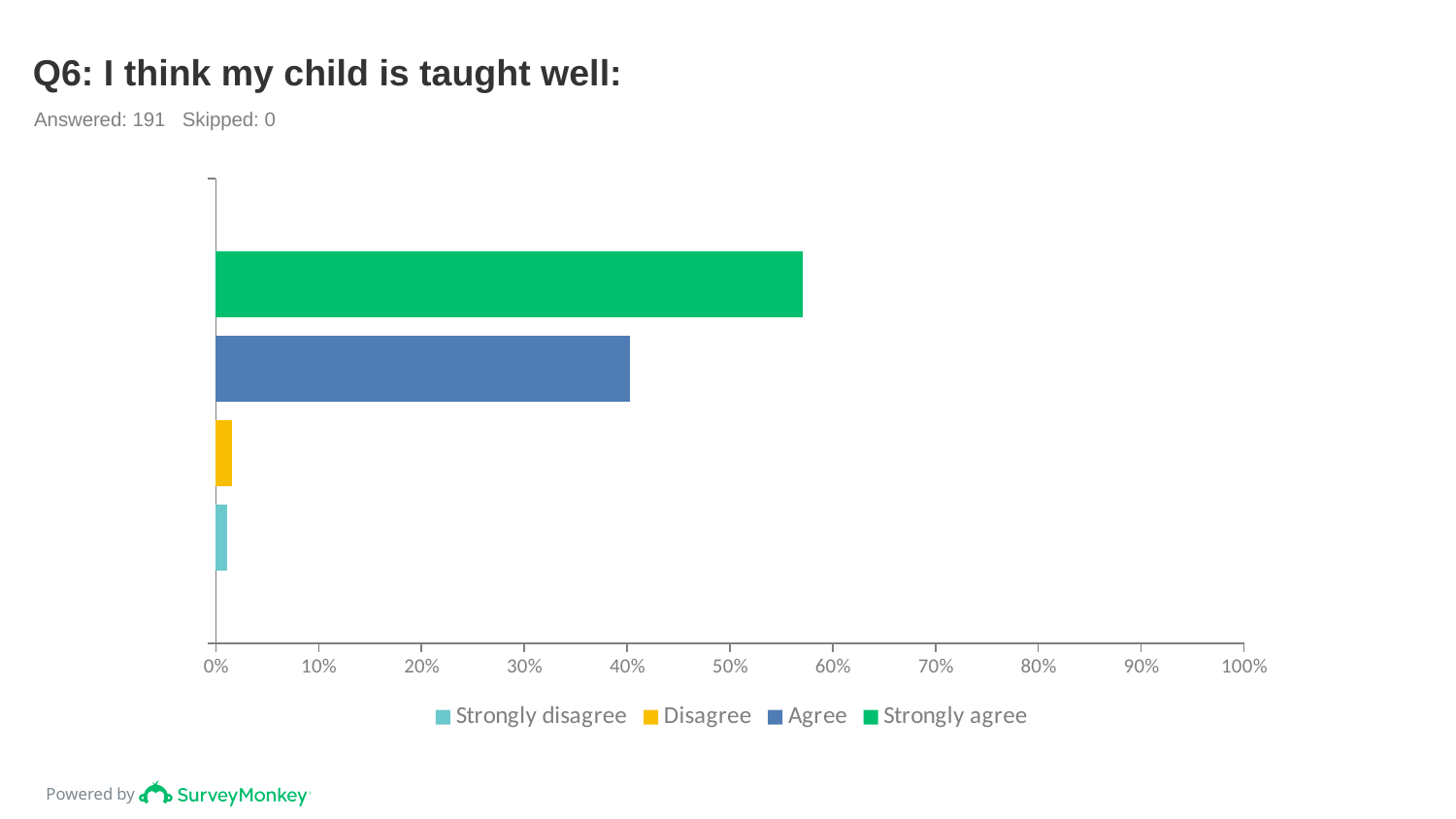
What is the title of the chart? Q6: I think my child is taught well: Which is larger, the value for Agree or the value for Strongly agree? Strongly agree Is the value for Strongly agree greater or less than 50%? greater Which response has the shortest bar? Strongly disagree Is the value for Disagree greater or less than 10%? less Is the value for Strongly agree greater or less than 60%? less Which response has the longest bar? Strongly agree How many series does the legend list? 4 What kind of chart is shown on the slide? Bar chart Which is larger, the value for Disagree or the value for Agree? Agree How many responses were answered according to the slide? 191